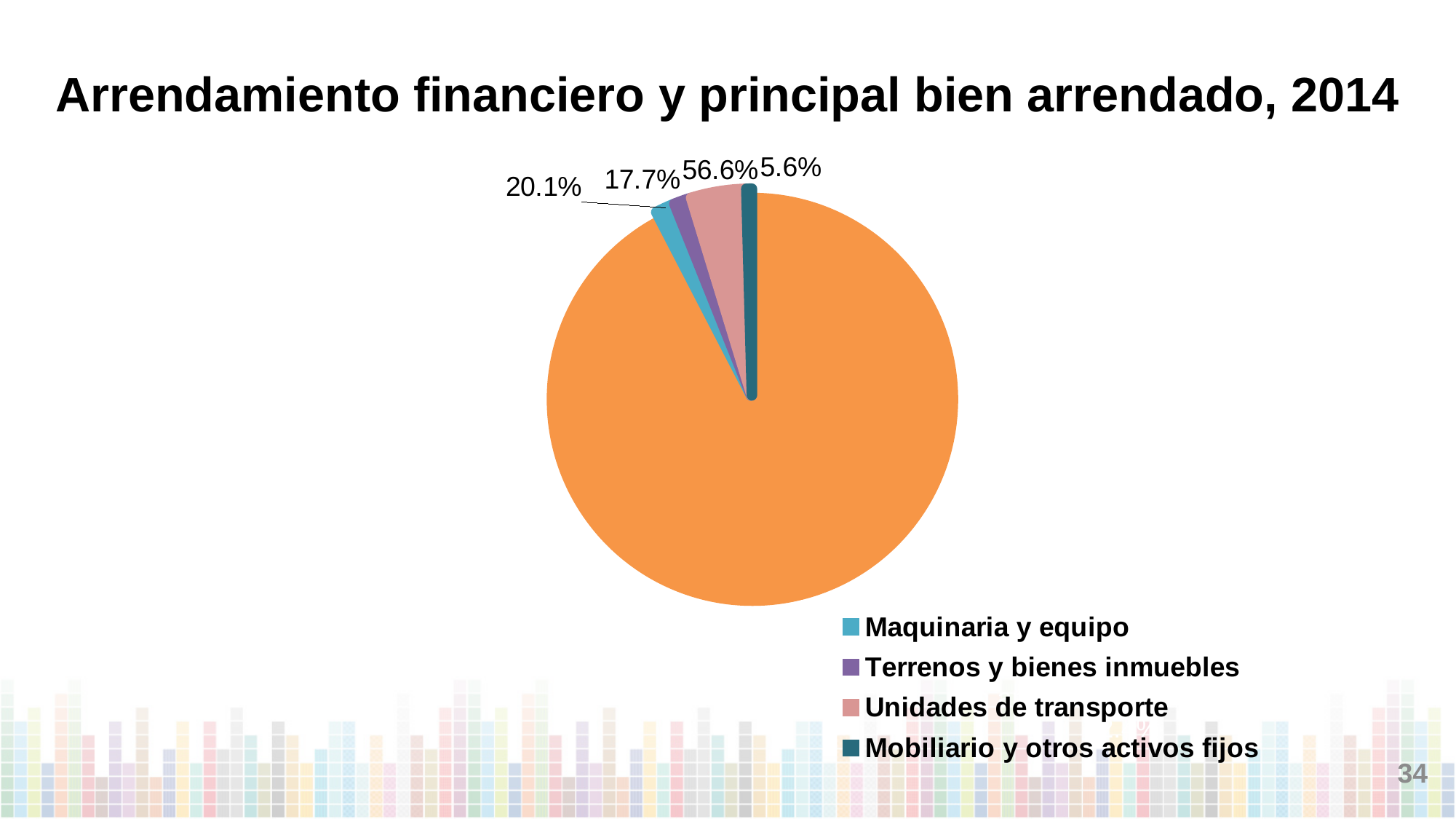
Which printed label is larger, 56.6% or 20.1%? 56.6% What percentage label is shown next to the Unidades de transporte slice? 56.6% Which legend entry is shown in purple? Terrenos y bienes inmuebles What is the difference between the 20.1% label and the 17.7% label? 2.4% What kind of chart is shown on the slide? pie chart What is the title of the chart? Arrendamiento financiero y principal bien arrendado, 2014 How many entries does the legend list? 4 What percentage label is shown next to the Terrenos y bienes inmuebles slice? 17.7% What percentage label is shown next to the Mobiliario y otros activos fijos slice? 5.6% What percentage label is attached by a leader line to the Maquinaria y equipo slice? 20.1% How many percentage labels are printed on the chart? 4